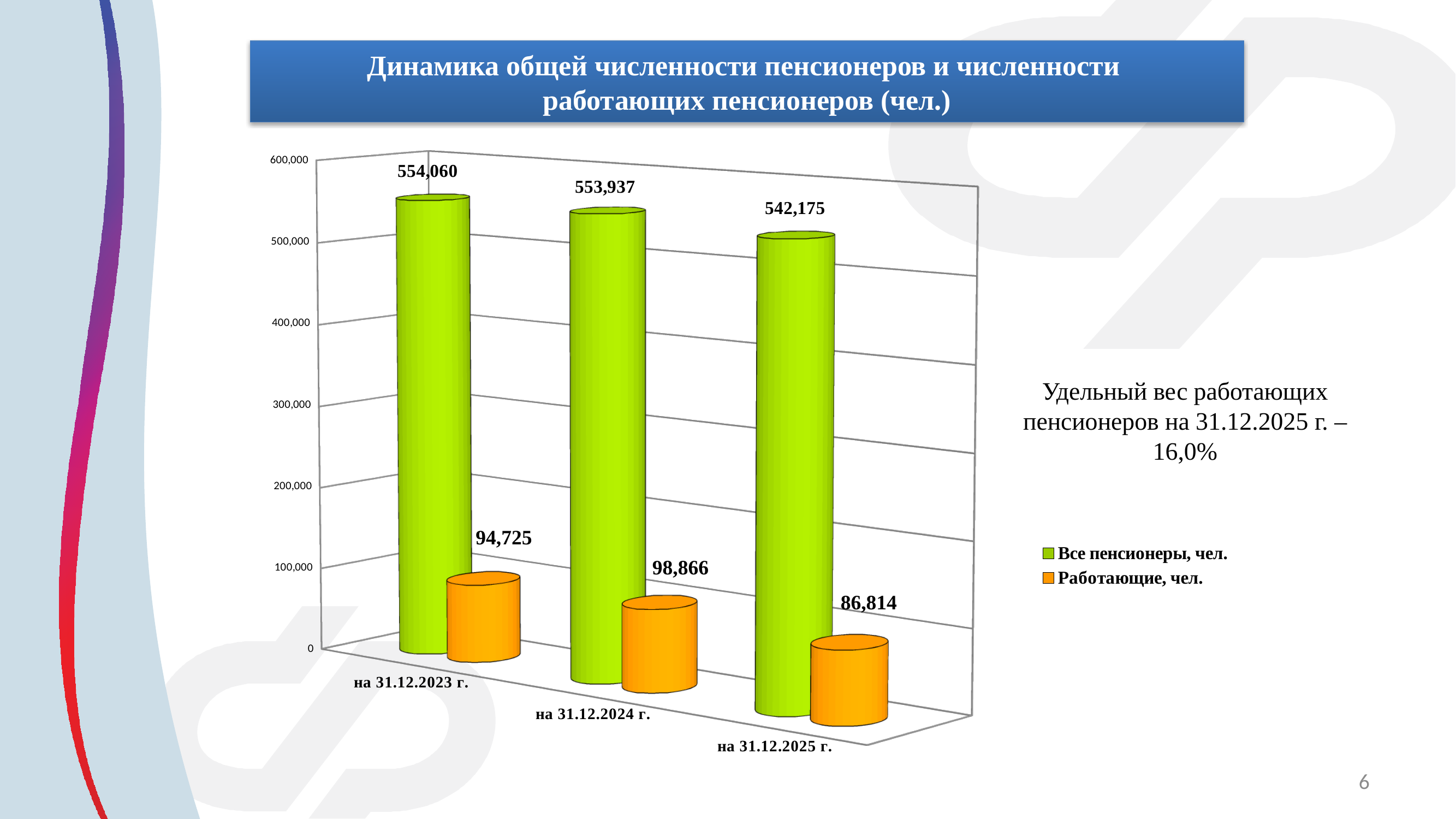
How many periods are shown on the x axis? 3 What is the value for "Все пенсионеры, чел." on 31.12.2023? 554,060 What kind of chart is shown on the slide? bar chart In which period is the value for "Все пенсионеры, чел." lowest? на 31.12.2025 г. In which period is the value for "Работающие, чел." highest? на 31.12.2024 г. What is the value for "Работающие, чел." on 31.12.2024? 98,866 How many series does the legend list? 2 Which is larger: the "Работающие, чел." value on 31.12.2023 or on 31.12.2025? на 31.12.2023 г. What is the value for "Работающие, чел." on 31.12.2025? 86,814 What is the difference between the "Работающие, чел." values on 31.12.2024 and 31.12.2025? 12,052 What is the difference between the "Все пенсионеры, чел." values on 31.12.2023 and 31.12.2025? 11,885 What is the value for "Все пенсионеры, чел." on 31.12.2025? 542,175